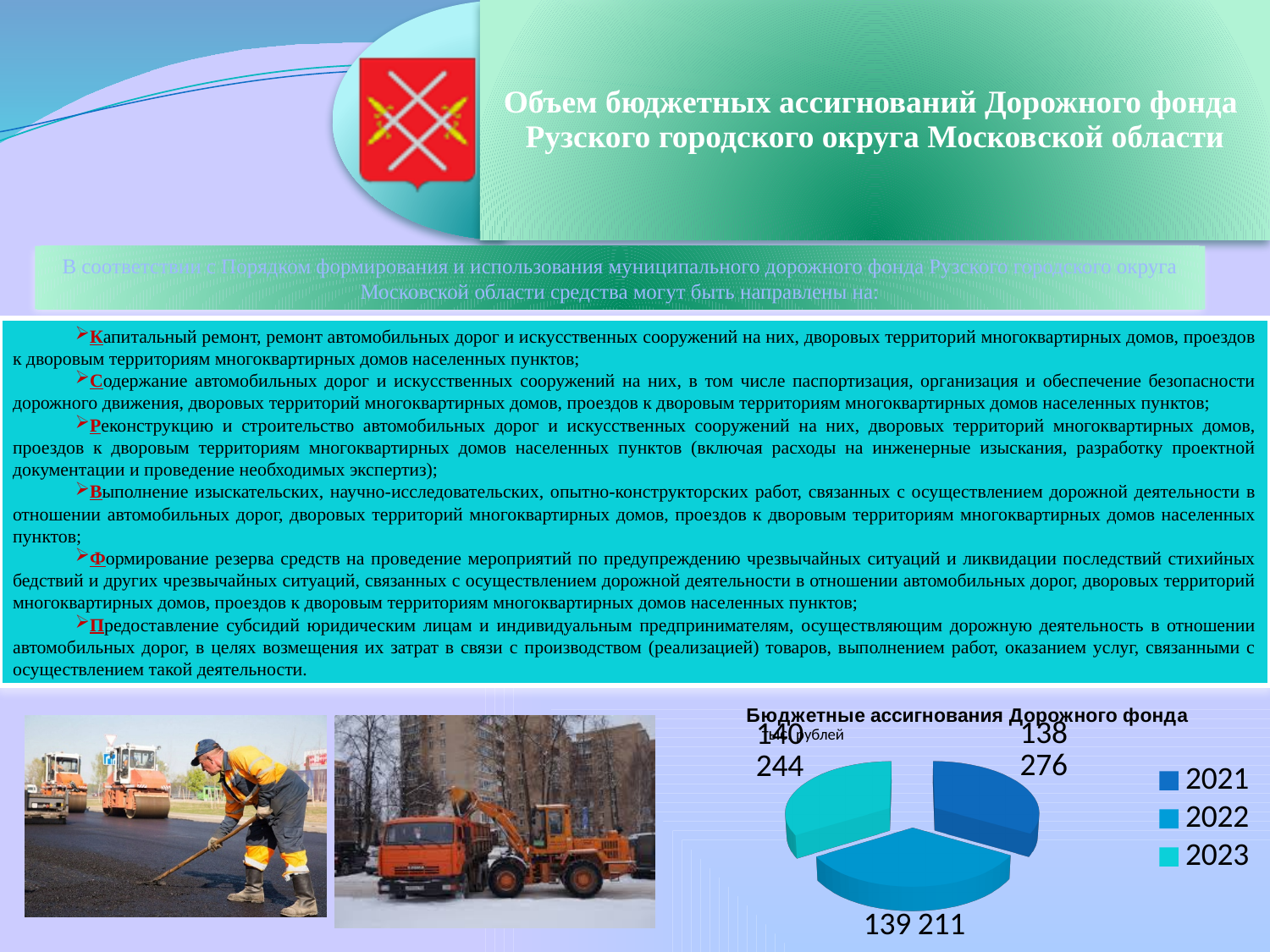
What kind of chart is shown on the slide? Pie chart What is the value shown for 2022 in the pie chart? 139 211 What is the value shown for 2023 in the pie chart? 140 244 Which is larger in the pie chart, the value for 2022 or the value for 2021? 2022 What is the title of the pie chart? Бюджетные ассигнования Дорожного фонда Which year has the largest value in the pie chart? 2023 What is the difference between the values for 2023 and 2021 in the pie chart? 1 968 What is the value shown for 2021 in the pie chart? 138 276 How many slices does the pie chart have? 3 What is the total of the three values shown in the pie chart? 417 731 Which year has the smallest value in the pie chart? 2021 How many entries does the legend of the pie chart list? 3